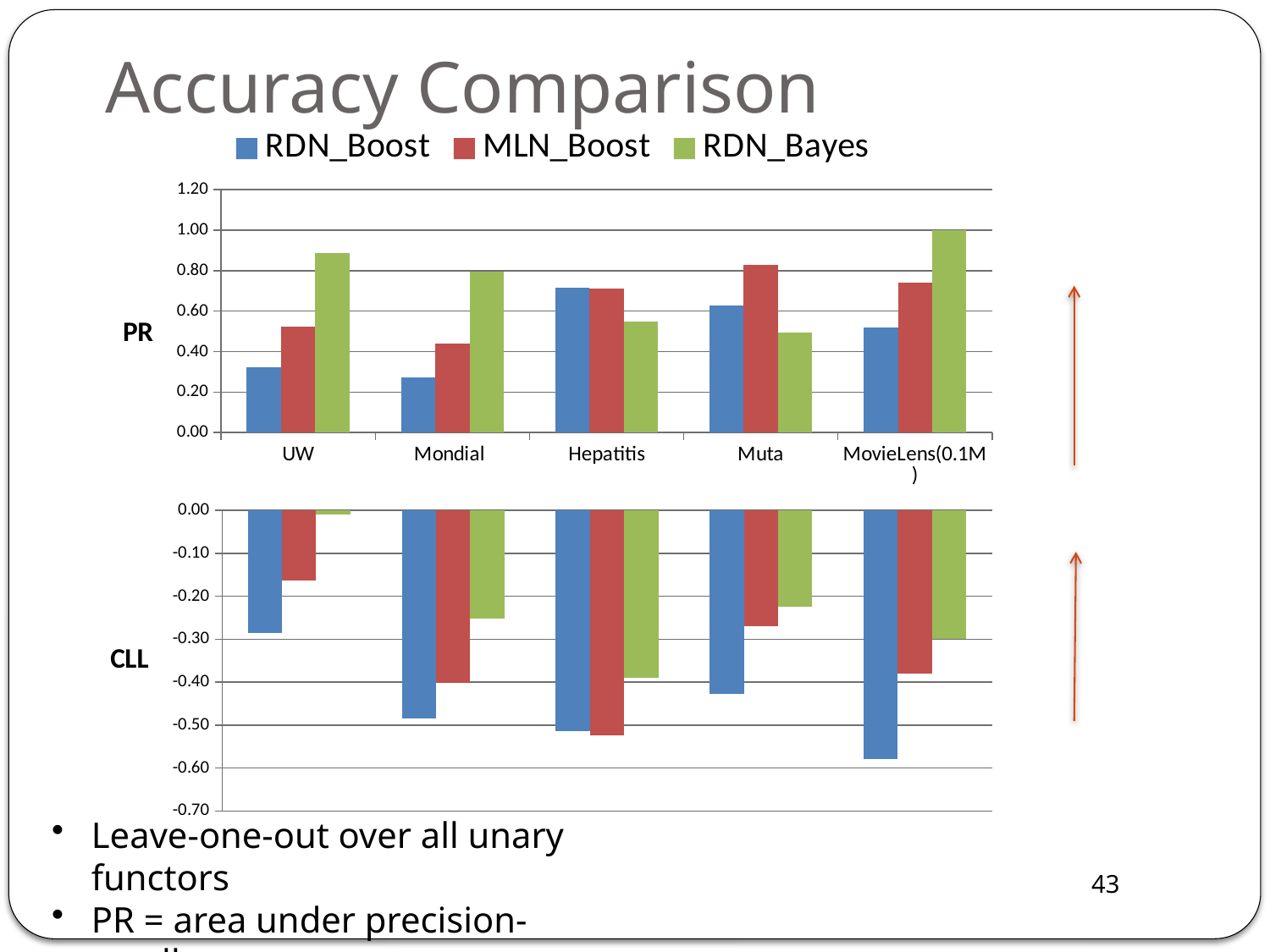
How many series does the legend list? 3 How many datasets are shown along the x axis of the PR chart? 5 In the CLL chart, is the RDN_Boost value for MovieLens(0.1M) greater or less than -0.50? less In the PR chart, which series has the highest value for Muta? MLN_Boost In the PR chart, which series has the highest value for UW? RDN_Bayes In the CLL chart, which series has the lowest value for MovieLens(0.1M)? RDN_Boost In the PR chart, for which dataset is the RDN_Bayes value highest? MovieLens(0.1M) In the PR chart, which is larger for Muta: MLN_Boost or RDN_Boost? MLN_Boost In the PR chart, is the RDN_Boost value for Mondial greater or less than 0.40? less What type of chart is used for the PR and CLL panels on this slide? bar chart Which colour represents RDN_Bayes in the legend? green In the PR chart, is the RDN_Bayes value for UW greater or less than 0.80? greater